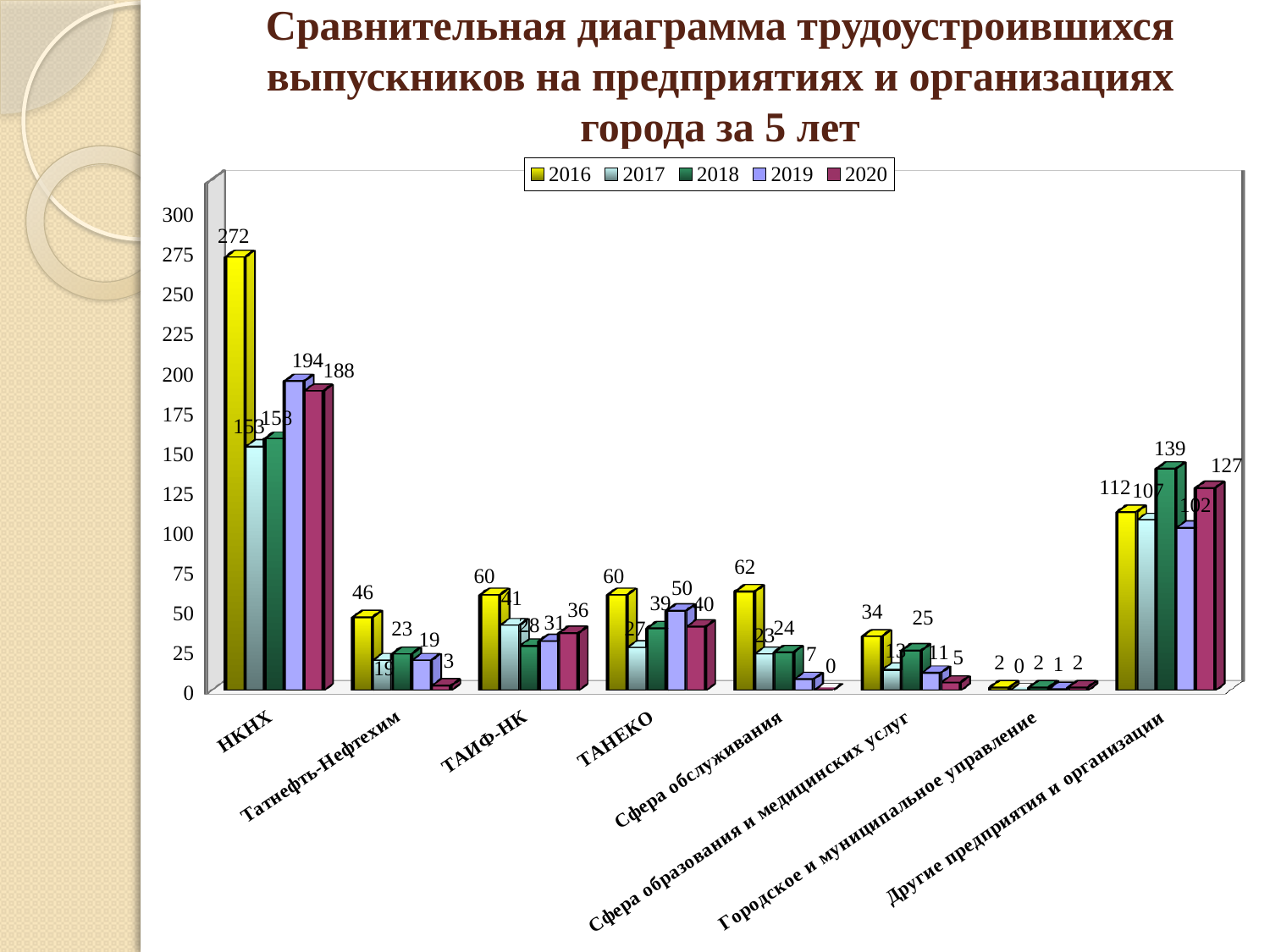
Is the value for Другие предприятия и организации in 2020 greater or less than 100? greater What is the value for НКНХ in 2016? 272 What is the value for Другие предприятия и организации in 2018? 139 What kind of chart is shown on the slide? Bar chart What is the value for Сфера обслуживания in 2020? 0 What is the value for ТАНЕКО in 2019? 50 How many series does the legend list? 5 How many categories are shown on the x axis? 8 Which category has the lowest value in 2019? Городское и муниципальное управление Which category has the highest value in 2016? НКНХ Which is larger for ТАИФ-НК: the 2017 value or the 2020 value? 2017 What is the difference between the 2016 and 2020 values for НКНХ? 84